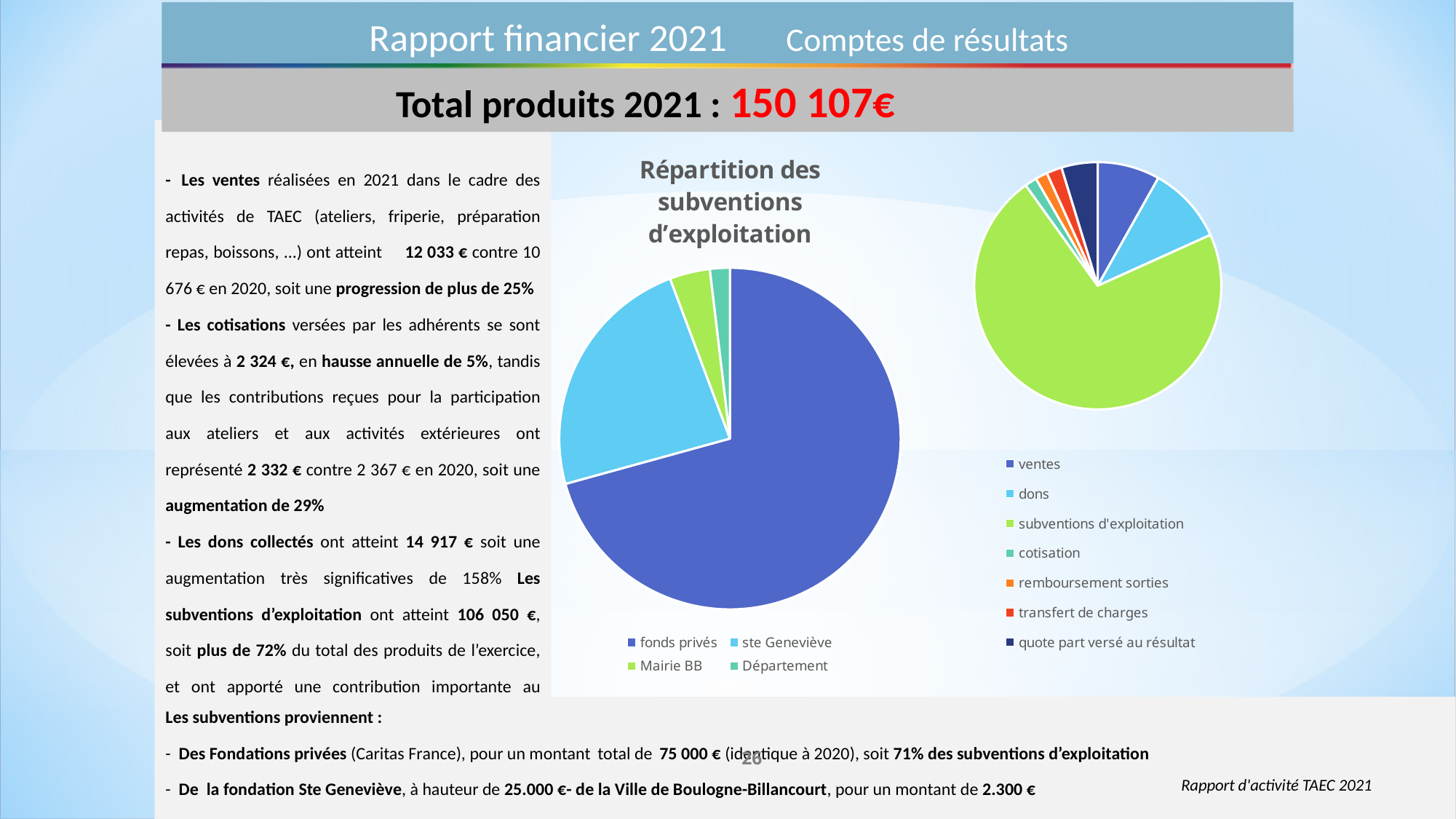
How many categories does the legend of the pie chart on the right side of the slide list? 7 How many categories does the legend of the chart titled 'Répartition des subventions d'exploitation' list? 4 In the chart titled 'Répartition des subventions d'exploitation', which category has the largest slice? fonds privés What kind of chart is the chart titled 'Répartition des subventions d'exploitation'? pie chart In the pie chart on the right side of the slide, which slice is larger: subventions d'exploitation or dons? subventions d'exploitation What kind of chart is the chart on the right side of the slide? pie chart In the pie chart on the right side of the slide, which category has the largest slice? subventions d'exploitation What is the title of the pie chart on the left side of the slide? Répartition des subventions d'exploitation In the pie chart on the right side of the slide, which slice is larger: ventes or transfert de charges? ventes In the pie chart on the right side of the slide, which category is shown in light green? subventions d'exploitation In the chart titled 'Répartition des subventions d'exploitation', which slice is larger: ste Geneviève or Mairie BB? ste Geneviève